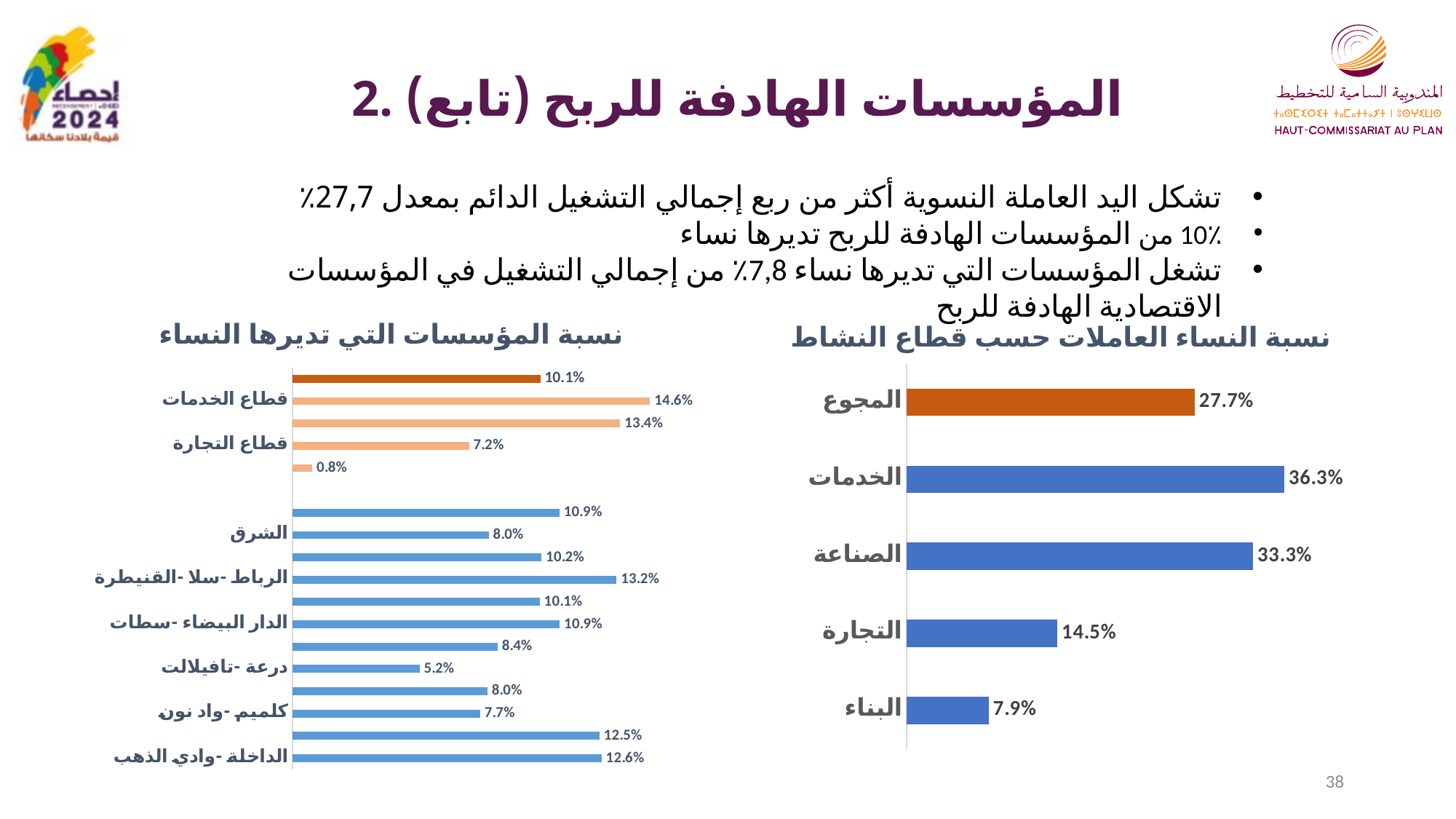
In the chart titled 'نسبة المؤسسات التي تديرها النساء', what is the value for درعة -تافيلالت? 5.2% In the chart titled 'نسبة النساء العاملات حسب قطاع النشاط', which category has the lowest value? البناء In the chart titled 'نسبة النساء العاملات حسب قطاع النشاط', which bar is coloured differently (orange) from the others? المجوع In the chart titled 'نسبة المؤسسات التي تديرها النساء', what is the difference between الداخلة -وادي الذهب and كلميم -واد نون? 4.9% In the chart titled 'نسبة النساء العاملات حسب قطاع النشاط', what kind of chart is it? bar chart In the chart titled 'نسبة المؤسسات التي تديرها النساء', what is the value for قطاع الخدمات? 14.6% In the chart titled 'نسبة النساء العاملات حسب قطاع النشاط', how many categories are shown? 5 In the chart titled 'نسبة النساء العاملات حسب قطاع النشاط', what is the difference between الخدمات and الصناعة? 3.0% In the chart titled 'نسبة النساء العاملات حسب قطاع النشاط', which category has the highest value? الخدمات In the chart titled 'نسبة المؤسسات التي تديرها النساء', which is larger: الرباط -سلا -القنيطرة or الشرق? الرباط -سلا -القنيطرة In the chart titled 'نسبة النساء العاملات حسب قطاع النشاط', what is the value for الخدمات? 36.3% In the chart titled 'نسبة النساء العاملات حسب قطاع النشاط', what is the value for البناء? 7.9%